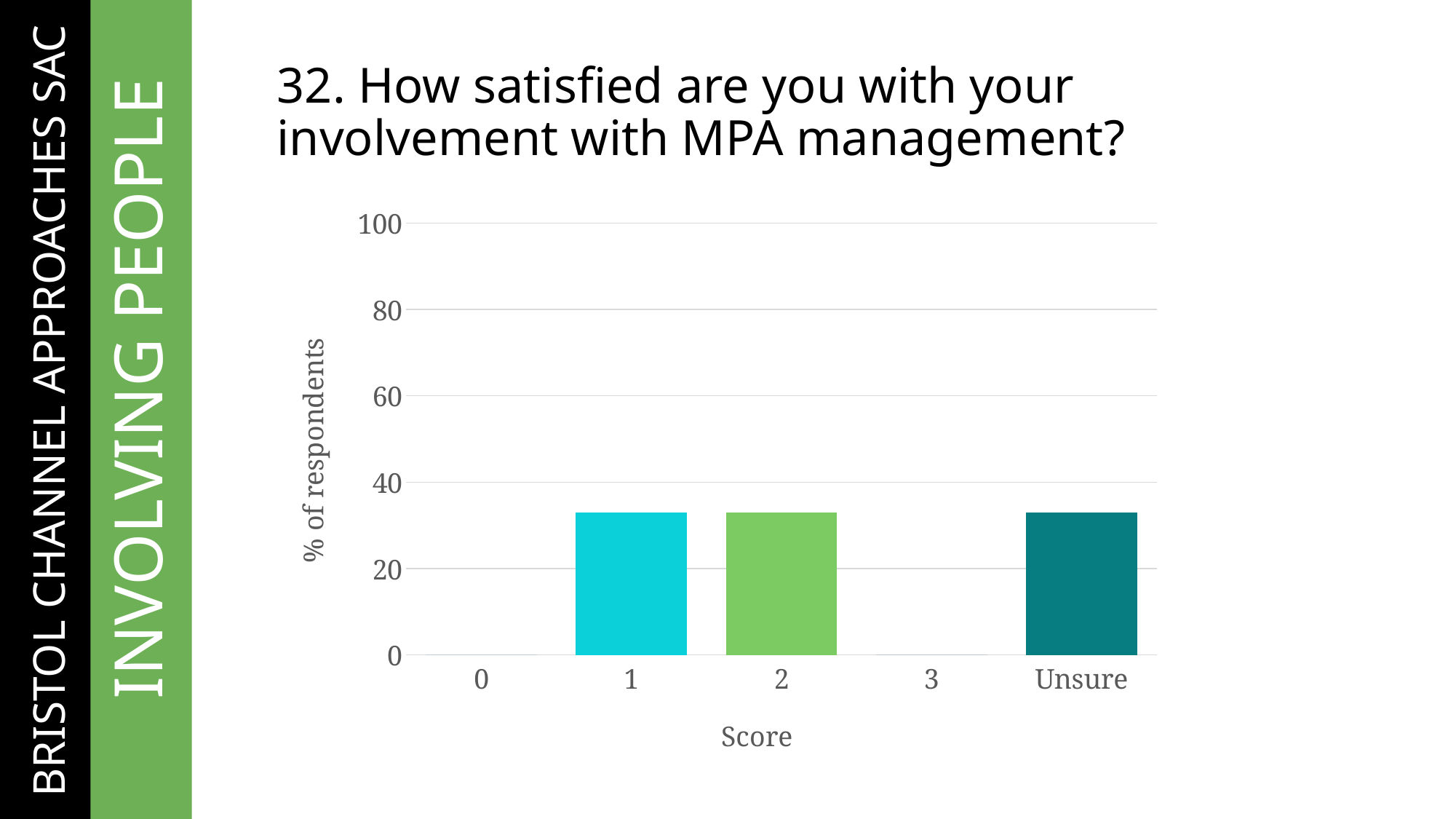
Which score categories have no bar (0% of respondents)? 0 and 3 What is the label of the y axis? % of respondents Is the value for score 2 greater or less than 40? less Which is larger, the value for score 3 or the value for Unsure? Unsure Is the value for Unsure greater or less than 20? greater Is the value for Unsure greater or less than 40? less Which is larger, the value for score 1 or the value for score 0? score 1 What is the label of the x axis? Score What kind of chart is shown on the slide? bar chart How many score categories are shown on the x axis? 5